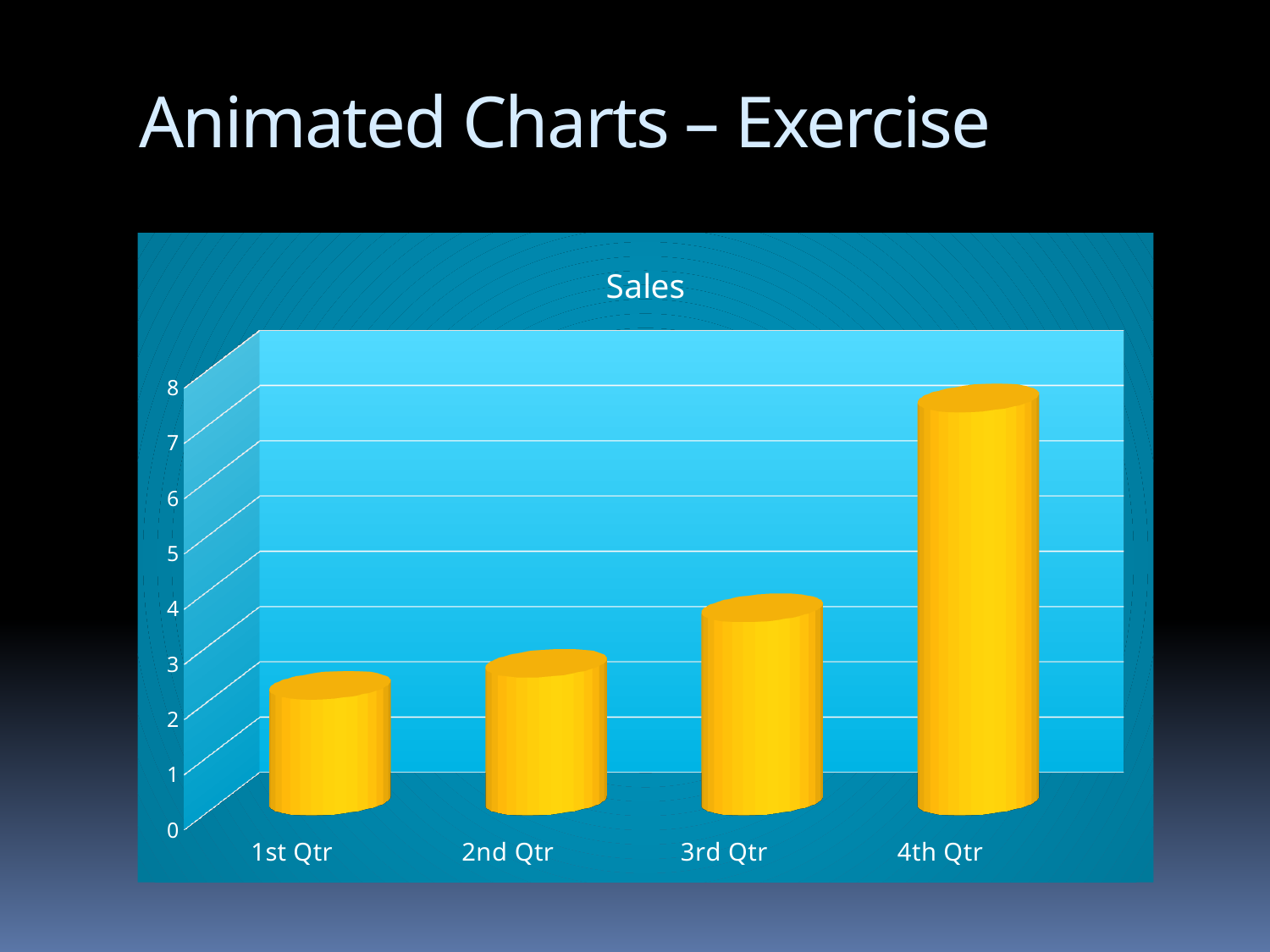
How many quarters are plotted on the chart? 4 What is the title of the chart? Sales What colour are the bars in the chart? yellow Do the sales values rise or fall from 1st Qtr to 4th Qtr? rise Is the value for 4th Qtr greater or less than 6? greater Which quarter has the lowest sales value? 1st Qtr Is the value for 2nd Qtr greater or less than 4? less Which quarter has the highest sales value? 4th Qtr Which is larger, the value for 3rd Qtr or the value for 2nd Qtr? 3rd Qtr What kind of chart is shown on the slide? bar chart Is the value for 3rd Qtr greater or less than 5? less